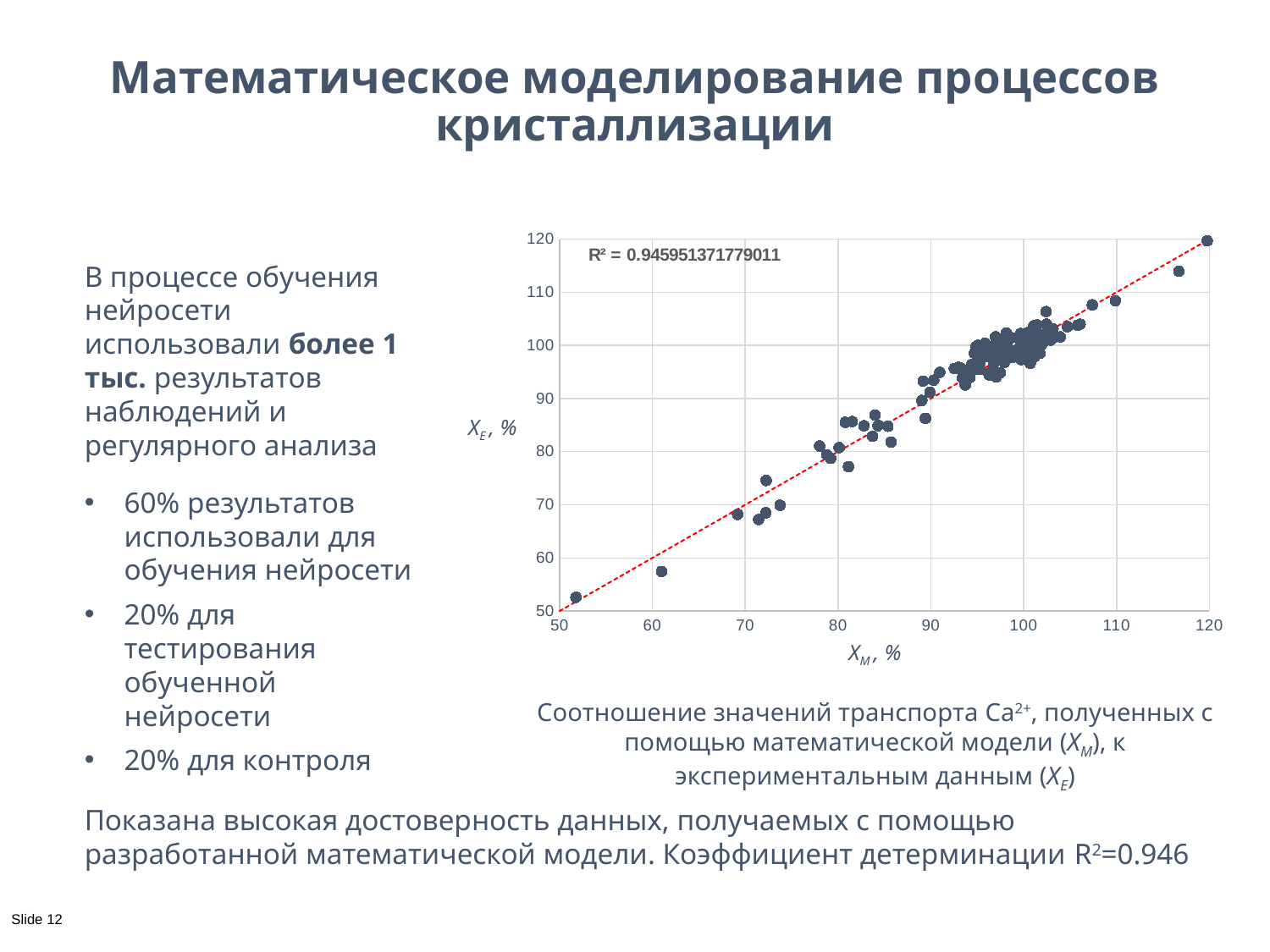
What kind of chart is shown on the slide? scatter chart What is the label of the y axis of the chart? X_E, % Do the plotted points rise or fall as X_M increases along the x axis? rise Is the X_E value of the lowest plotted point greater or less than 60? less What R² value is printed on the chart? R² = 0.945951371779011 What is the label of the x axis of the chart? X_M, % Is the X_M value of the highest plotted point greater or less than 110? greater